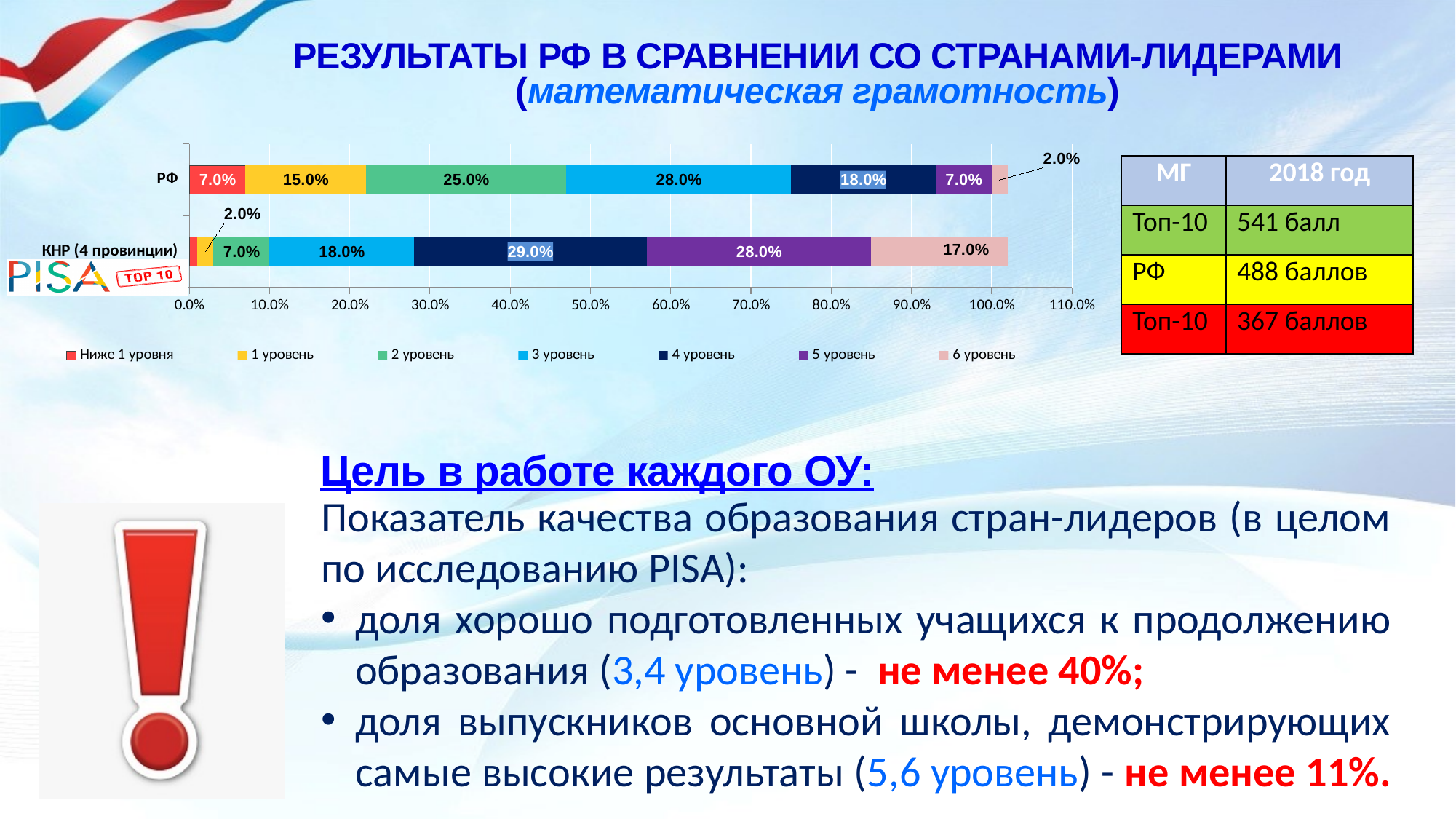
Which series has the largest share in the РФ bar? 3 уровень What is the difference between the 2 уровень values for РФ and КНР (4 провинции)? 18.0% How many categories (bars) are shown in the chart? 2 What is the value for 6 уровень in the РФ bar? 2.0% Which has the larger value for 5 уровень, РФ or КНР (4 провинции)? КНР (4 провинции) What is the value for 3 уровень in the РФ bar? 28.0% What kind of chart is shown on the slide? Stacked bar chart How much larger is the 4 уровень value for КНР (4 провинции) than for РФ? 11.0% How many series does the legend list? 7 What is the value for 2 уровень in the РФ bar? 25.0% What is the value for 4 уровень in the КНР (4 провинции) bar? 29.0% What is the value for 6 уровень in the КНР (4 провинции) bar? 17.0%